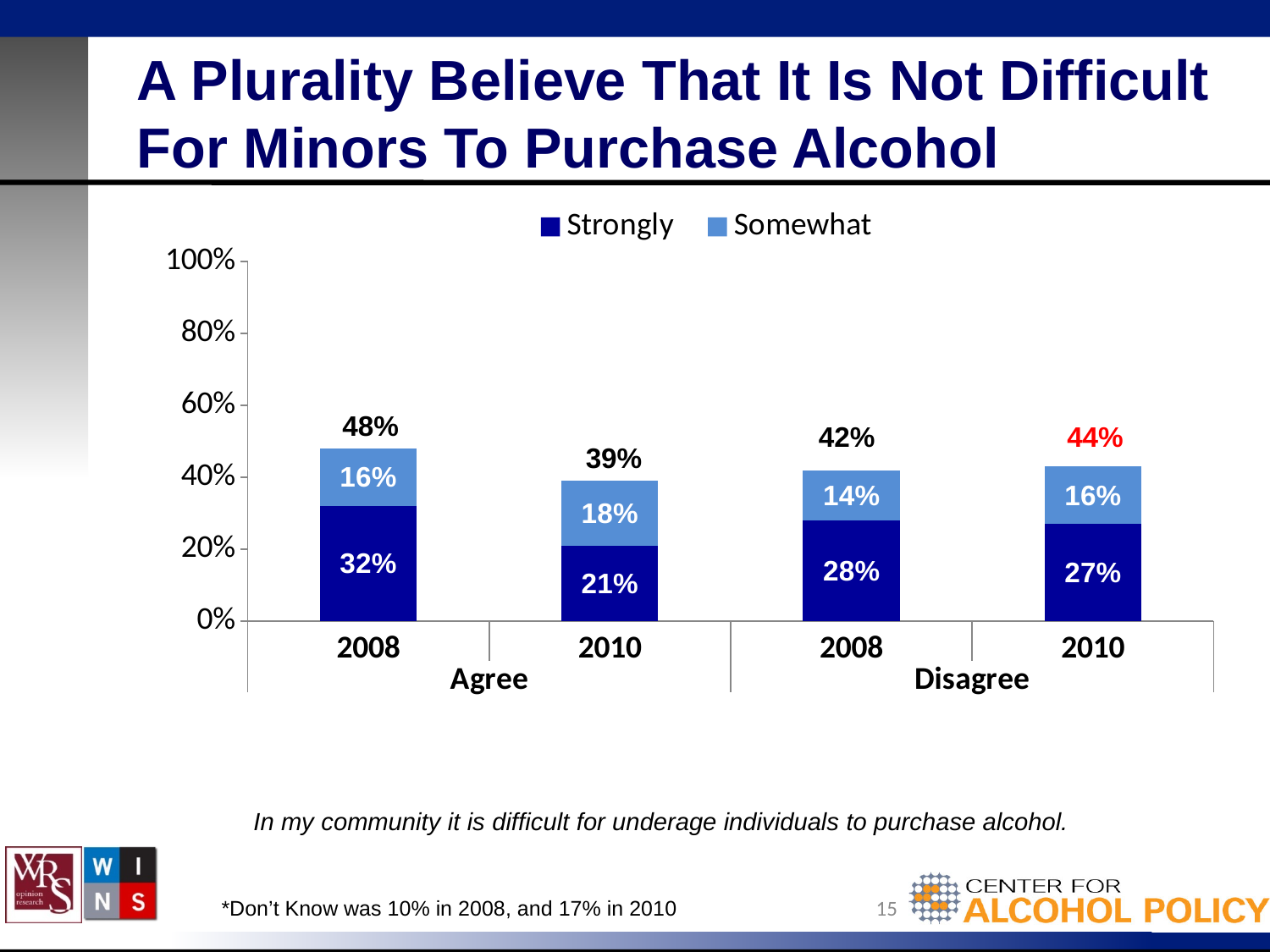
What is the total for the Agree 2010 bar? 39% How many series does the legend list? 2 What is the Strongly value for Agree in 2008? 32% Which bar has the lowest total? Agree 2010 Which series is shown in dark blue? Strongly Which bar has the highest total? Agree 2008 How many bars are shown in the chart? 4 What is the total for the Disagree 2010 bar? 44% Which is larger, the Somewhat value for Agree 2010 or the Somewhat value for Disagree 2008? Agree 2010 What is the difference between the Strongly values for Agree in 2008 and 2010? 11% What kind of chart is shown? Stacked bar chart What is the Somewhat value for Disagree in 2010? 16%